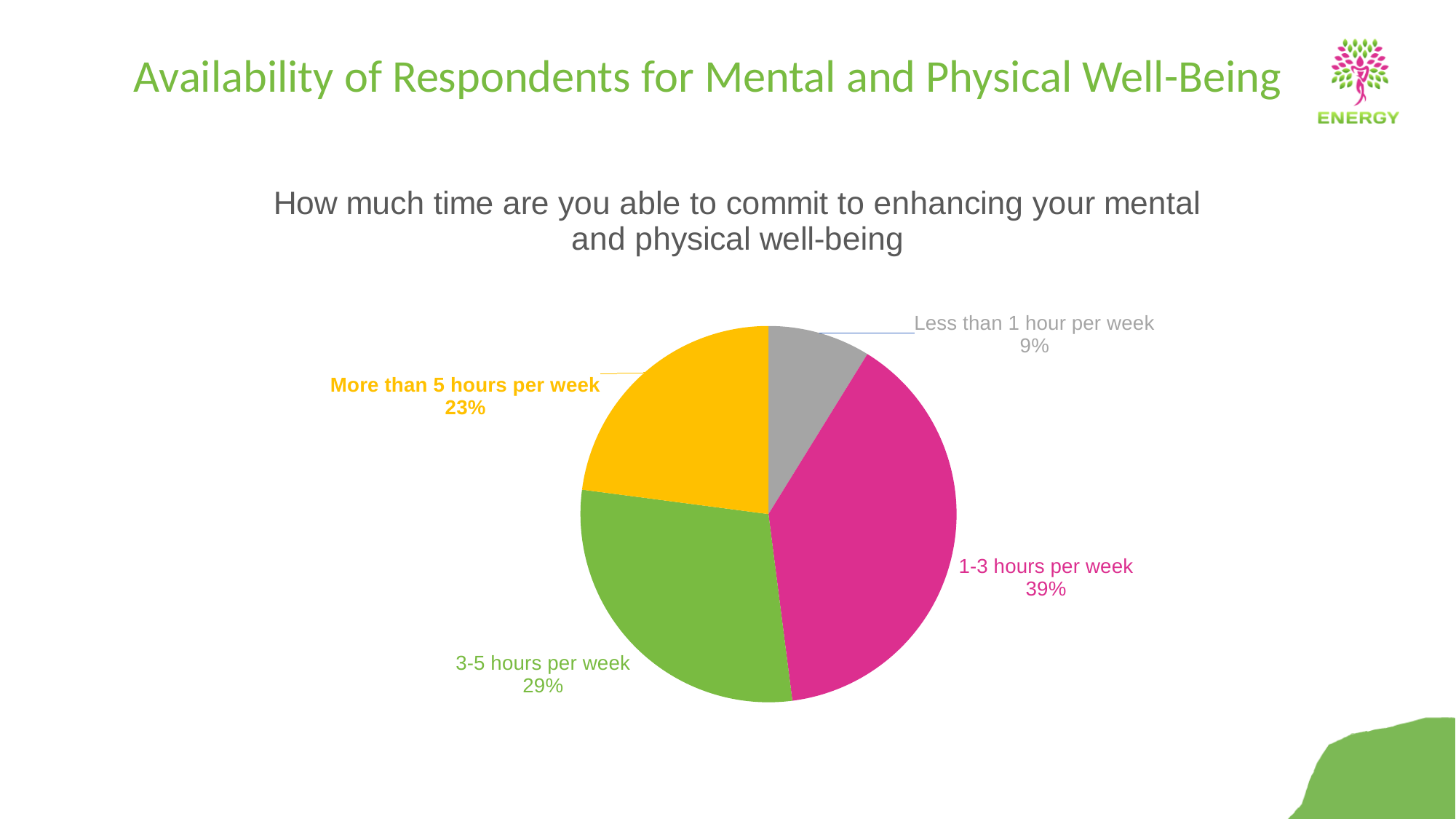
Which category has the largest share of the pie? 1-3 hours per week Which category has the smallest share of the pie? Less than 1 hour per week What share of respondents can commit less than 1 hour per week? 9% What is the difference in percentage points between the 1-3 hours per week and 3-5 hours per week slices? 10 Which is larger: the share for 3-5 hours per week or the share for more than 5 hours per week? 3-5 hours per week How many categories are shown in the pie chart? 4 What share of respondents can commit more than 5 hours per week? 23% What is the combined share of respondents who can commit 3 or more hours per week? 52% What colour is the slice for 1-3 hours per week? Pink What share of respondents can commit 3-5 hours per week? 29% What kind of chart is shown on the slide? Pie chart What share of respondents can commit 1-3 hours per week? 39%